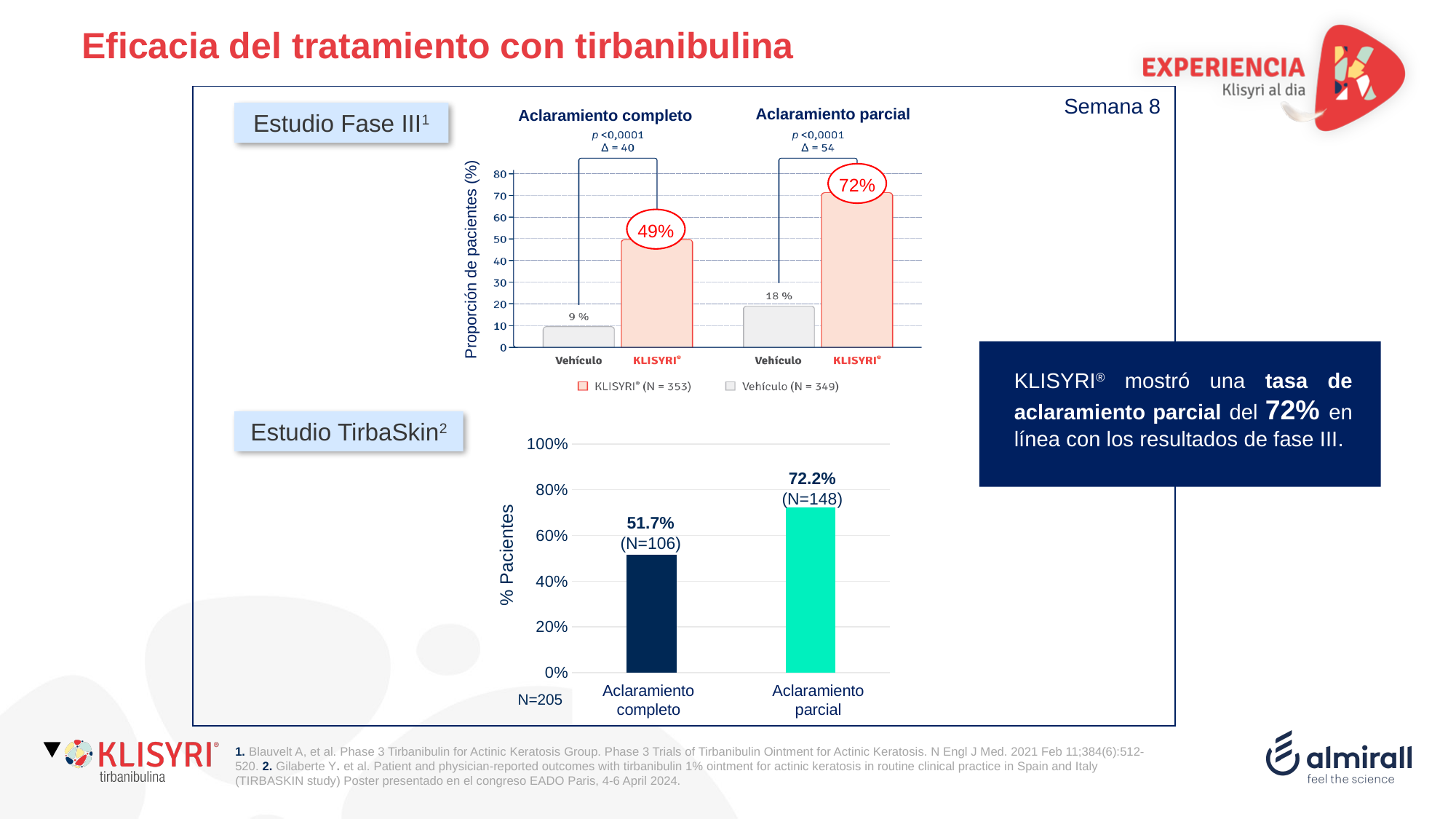
In the Estudio Fase III chart, what is the N for the KLISYRI group shown in the legend? 353 In the Estudio Fase III chart, what is the difference between KLISYRI and Vehículo in Aclaramiento parcial? 54 In the Estudio Fase III chart, what is the value for Vehículo in Aclaramiento parcial? 18 % In the Estudio TirbaSkin chart, what is the value for Aclaramiento completo? 51.7% In the Estudio Fase III chart, how many series does the legend list? 2 What kind of chart is the Estudio TirbaSkin chart? Bar chart In the Estudio TirbaSkin chart, what is the value for Aclaramiento parcial? 72.2% In the Estudio Fase III chart, what is the value for KLISYRI in Aclaramiento completo? 49% In the Estudio Fase III chart, what is the value for Vehículo in Aclaramiento completo? 9 % In the Estudio Fase III chart, which bar is the highest? KLISYRI, Aclaramiento parcial In the Estudio TirbaSkin chart, which category has the lower value? Aclaramiento completo In the Estudio TirbaSkin chart, what is the difference between Aclaramiento parcial and Aclaramiento completo? 20.5%